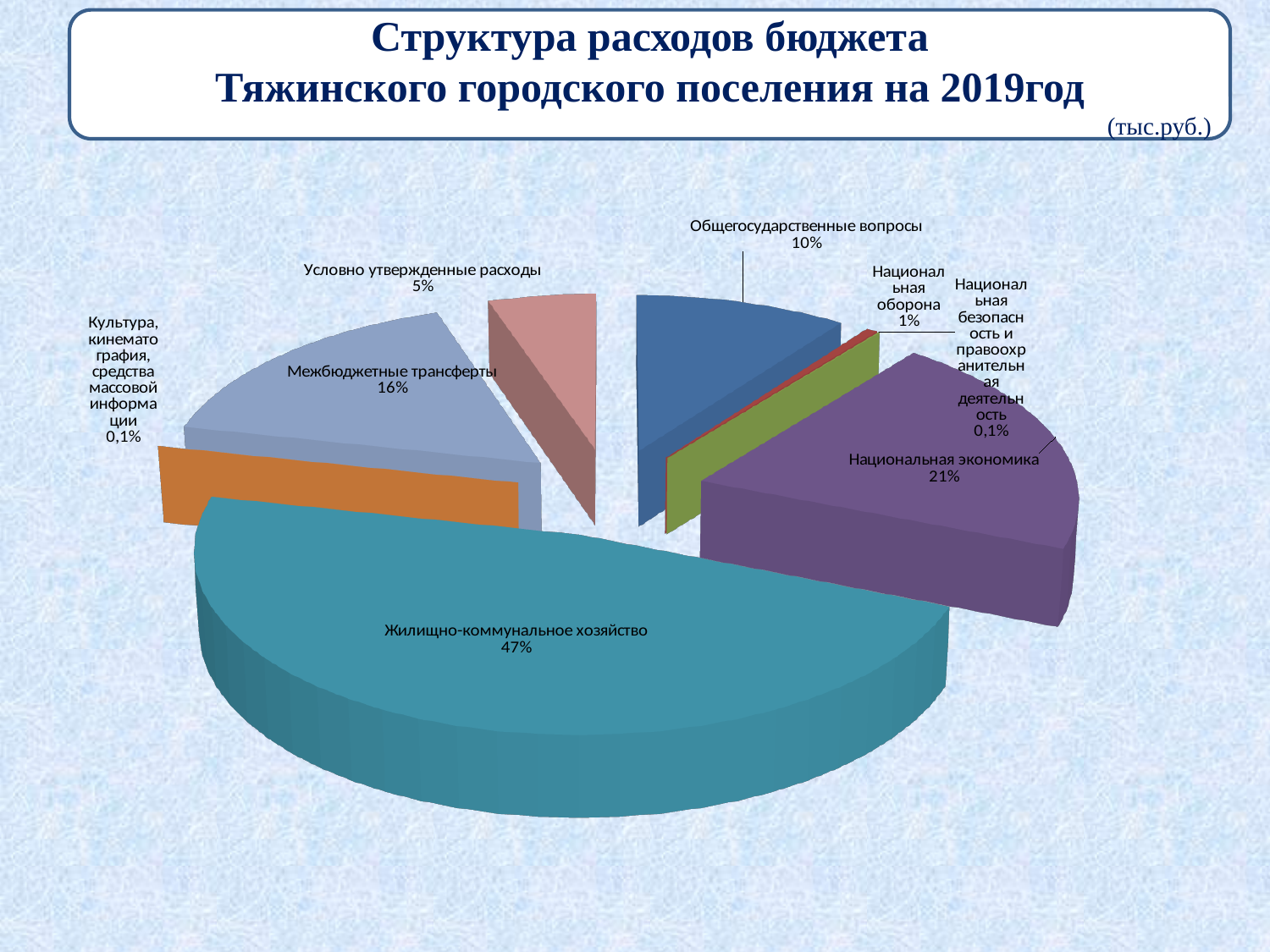
What share is shown for Межбюджетные трансферты? 16% What share of the budget expenditure goes to Жилищно-коммунальное хозяйство? 47% What share is shown for Общегосударственные вопросы? 10% How many categories (slices) does the pie chart have? 8 What is the title of the chart on the slide? Структура расходов бюджета Тяжинского городского поселения на 2019год Which category has the largest share of the pie? Жилищно-коммунальное хозяйство What kind of chart is shown on the slide? Pie chart Which is larger: the share for Национальная экономика or the share for Межбюджетные трансферты? Национальная экономика What is the difference in percentage points between Жилищно-коммунальное хозяйство and Национальная экономика? 26